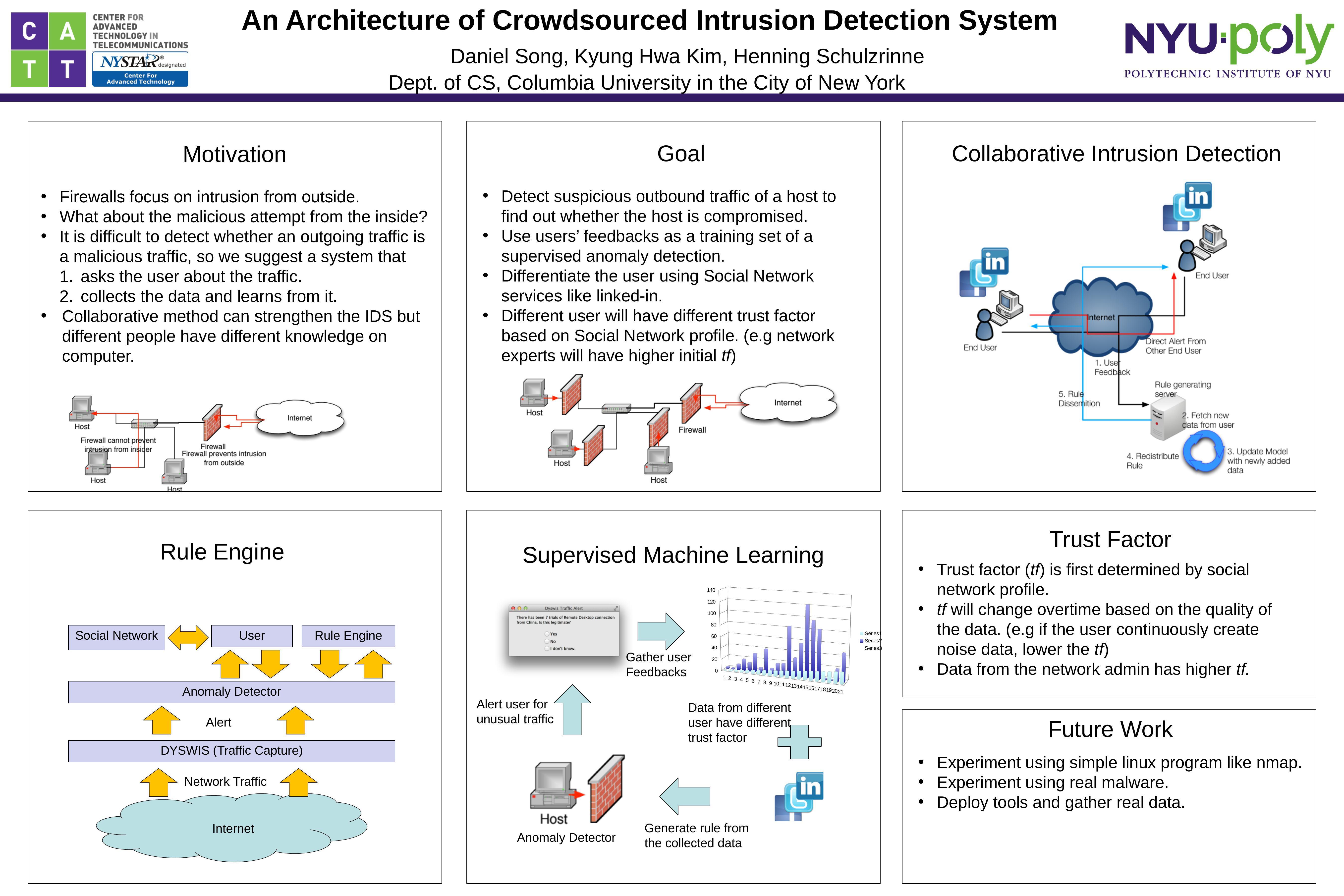
Which has the taller bar in the chart, category 15 or category 1? category 15 How many series does the legend of the bar chart list? 3 Is the tallest bar in the chart (at category 15) greater or less than 100? greater What is the highest tick value shown on the y axis of the bar chart? 140 How many categories are shown along the x axis of the bar chart? 21 What kind of chart is shown in the Supervised Machine Learning section? bar chart What are the legend entries of the bar chart? Series1, Series2, Series3 Are the bars for category 2 greater or less than 60? less Are the bars for category 1 greater or less than 40? less Which x-axis category has the tallest bar in the chart? 15